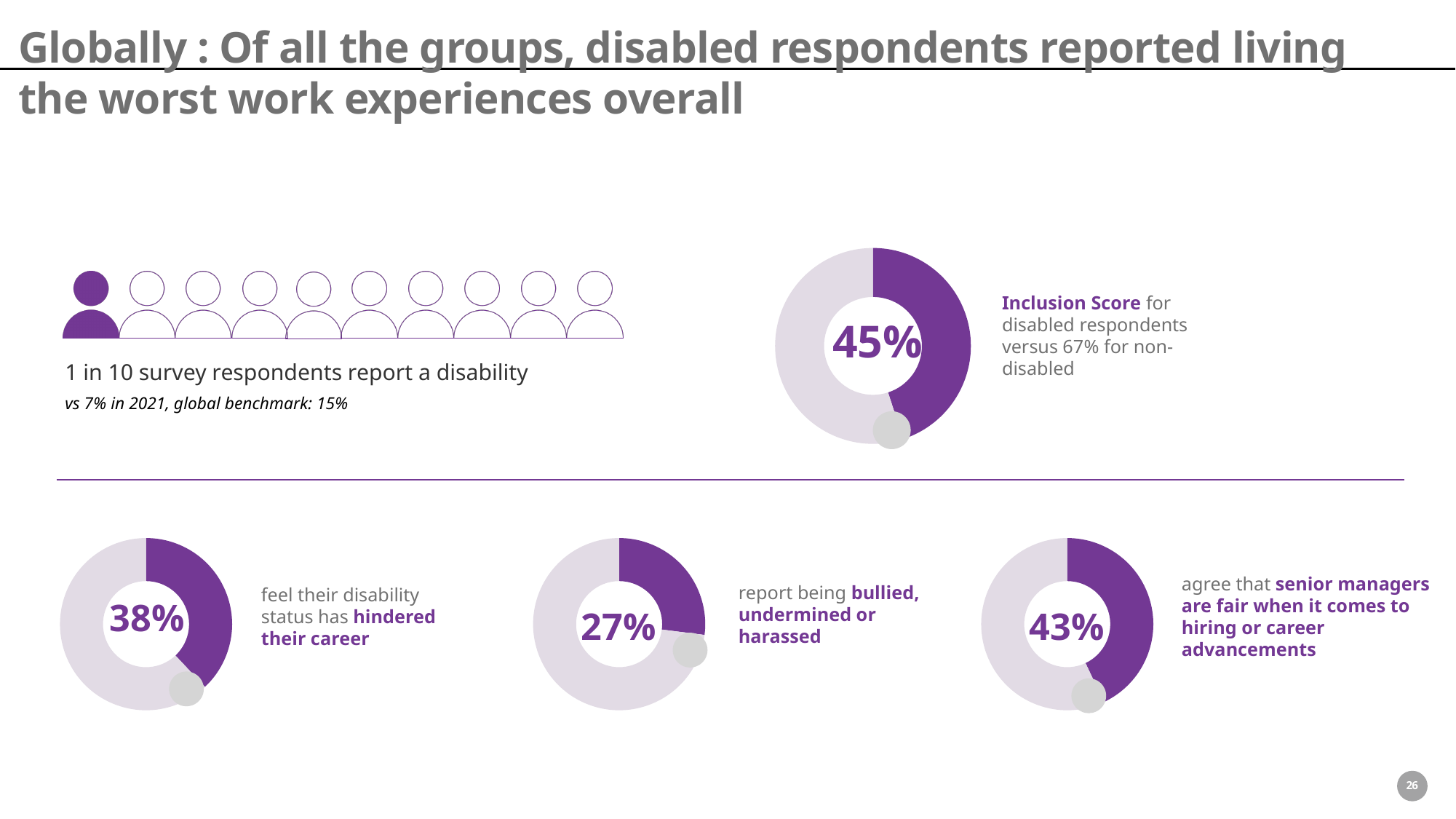
In the bottom-right donut chart, what percentage agree that senior managers are fair when it comes to hiring or career advancements? 43% How many donut charts are shown on the slide? 4 What kind of chart is used to show the 45% Inclusion Score? Donut chart What is the difference in percentage points between the bottom-left donut (38%) and the bottom-middle donut (27%)? 11 percentage points In the pictogram on the left, how many person icons are shown and how many are filled in? 10 icons, 1 filled In the bottom-left donut chart, what percentage feel their disability status has hindered their career? 38% By how many percentage points is the Inclusion Score for non-disabled respondents higher than for disabled respondents? 22 percentage points According to the text next to the top-right donut chart, what is the Inclusion Score for non-disabled respondents? 67% Of the three donut charts in the bottom row, which statement has the lowest percentage? Report being bullied, undermined or harassed (27%) Of the three donut charts in the bottom row, which statement has the highest percentage? Agree that senior managers are fair when it comes to hiring or career advancements (43%) In the bottom-middle donut chart, what percentage report being bullied, undermined or harassed? 27% In the top-right donut chart, what is the Inclusion Score for disabled respondents? 45%